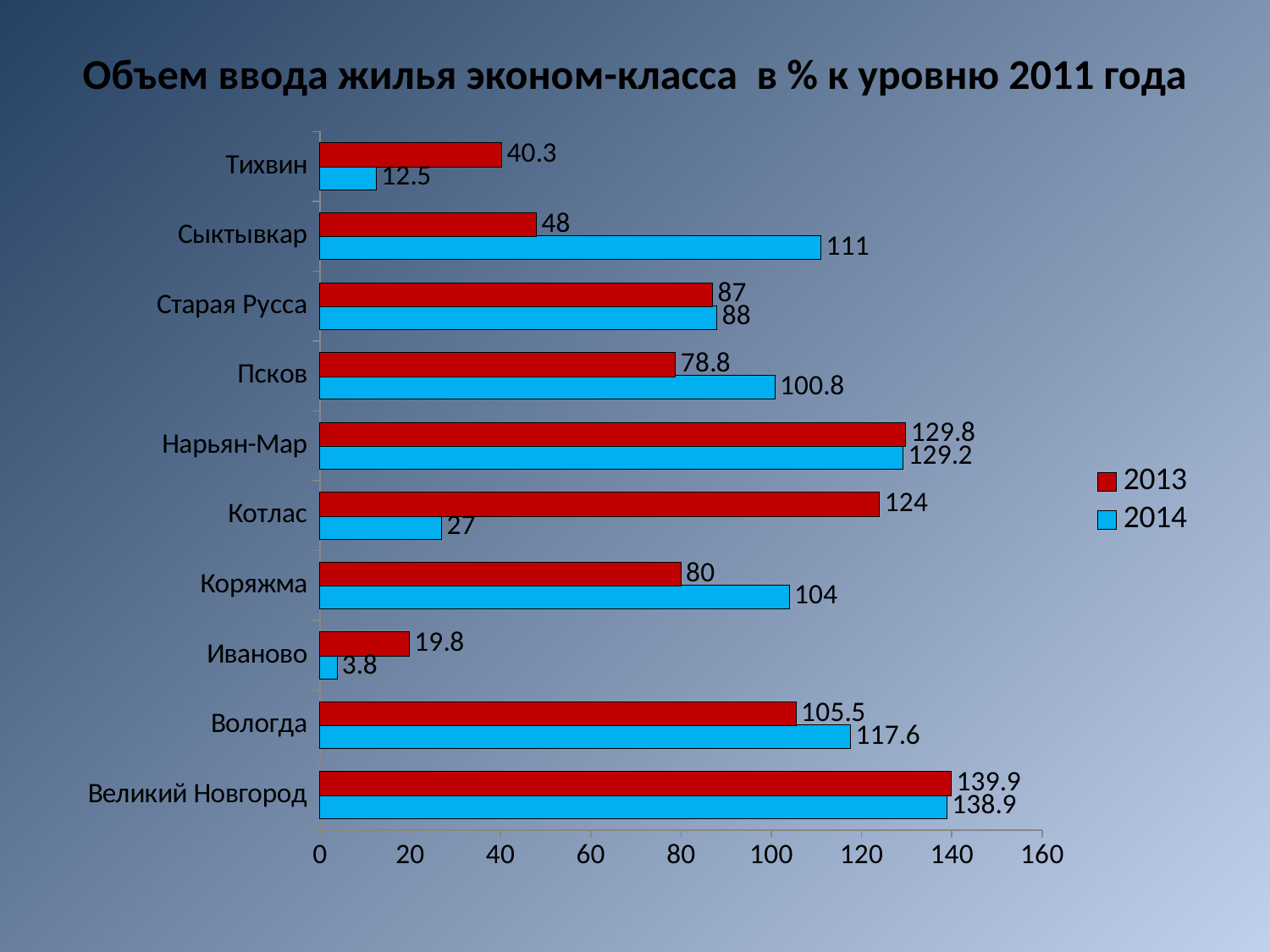
What is the 2013 value for Котлас? 124 For Коряжма, which year has the larger value, 2013 or 2014? 2014 Which city has the highest 2013 value? Великий Новгород Is the 2014 value for Вологда greater or less than 100? greater Which city has the lowest 2014 value? Иваново What type of chart is shown on the slide? bar chart What is the difference between the 2013 and 2014 values for Котлас? 97 How many cities are shown on the chart? 10 How many series does the legend list? 2 What is the difference between the 2014 and 2013 values for Сыктывкар? 63 What is the 2014 value for Псков? 100.8 What is the 2014 value for Сыктывкар? 111